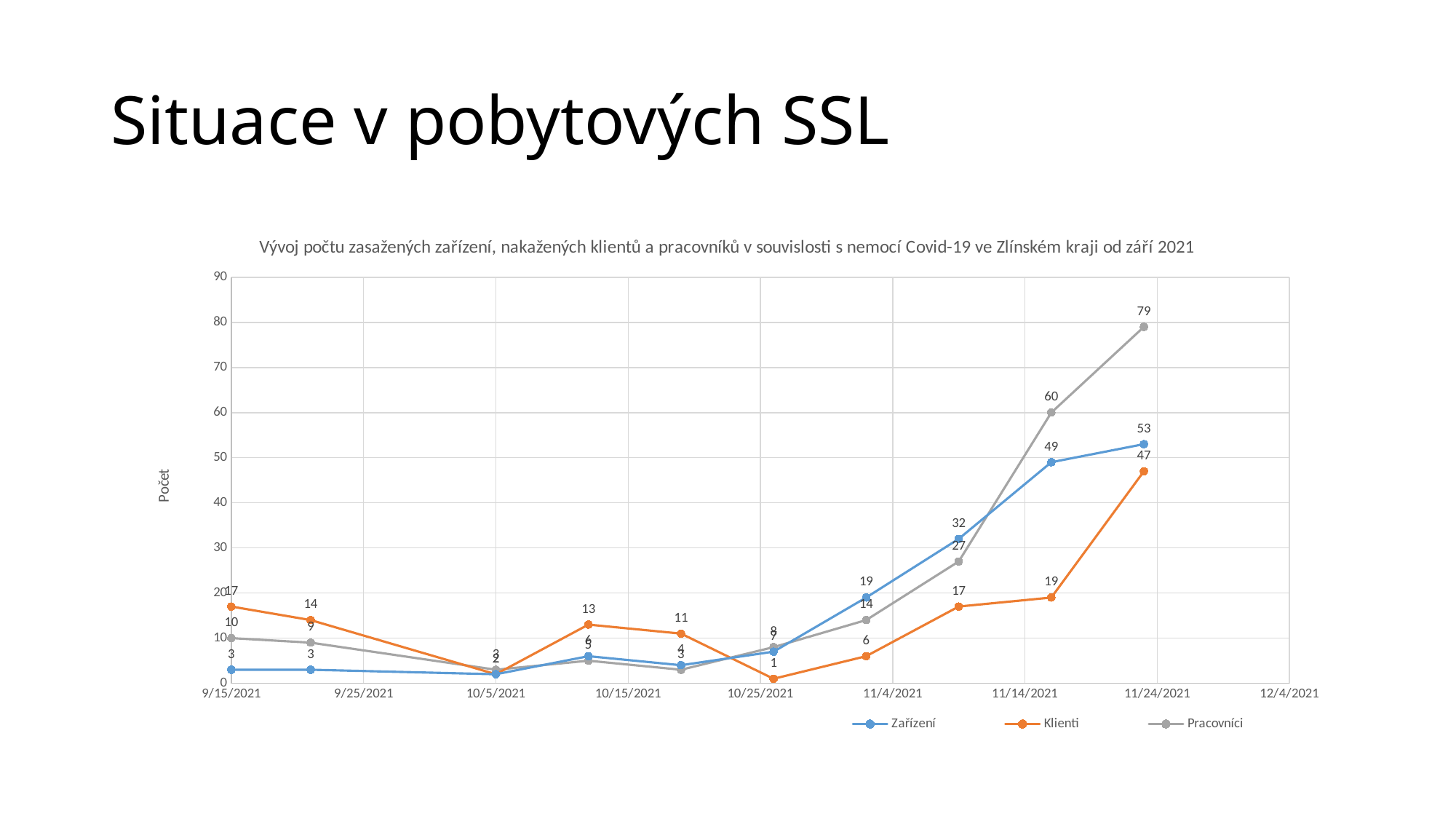
What type of chart is shown on the slide? line chart What is the value of the Klienti series on 9/15/2021? 17 What is the highest value reached by the Pracovníci series? 79 What is the value of the Pracovníci series on 9/15/2021? 10 How many series does the legend list? 3 Is the final value of the Pracovníci series greater or less than 70? greater What is the title of the vertical axis? Počet What is the value of the Klienti series on 10/25/2021? 1 What is the value of the Zařízení series on 9/15/2021? 3 Does the Pracovníci series rise or fall from 10/25/2021 to the end of the chart? rise At the final data point, what is the difference between the Pracovníci value (79) and the Zařízení value (53)? 26 At the final data point, which series has the larger value: Zařízení or Klienti? Zařízení